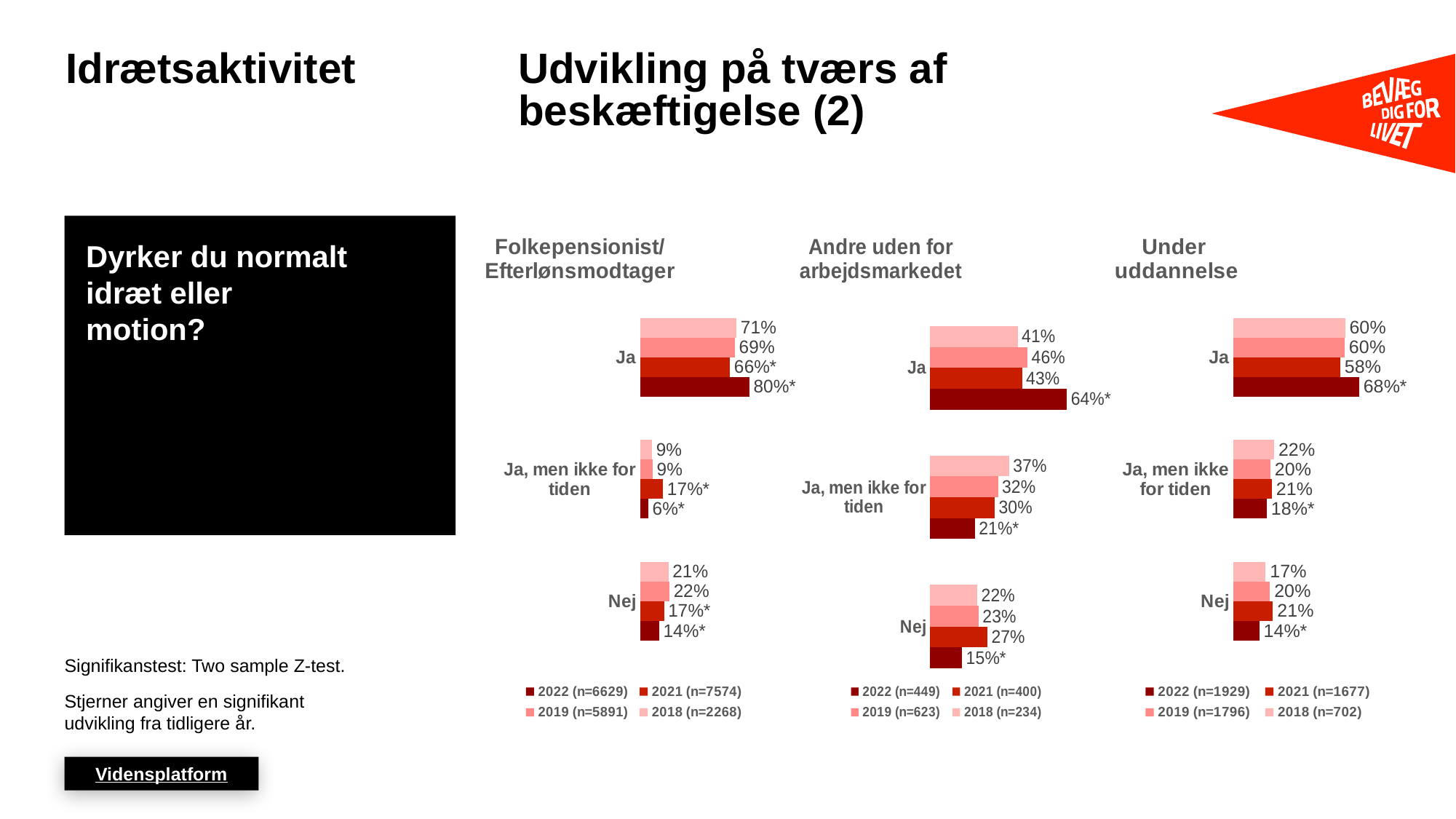
In the 'Under uddannelse' chart, what is the value for 'Nej' in 2021? 21% In the 'Andre uden for arbejdsmarkedet' chart, which year has the highest value for 'Ja'? 2022 In the 'Folkepensionist/Efterlønsmodtager' chart, what is the value for 'Ja' in 2022? 80%* In the 'Andre uden for arbejdsmarkedet' chart, what is the sample size (n) for 2022 shown in the legend? 449 In the 'Folkepensionist/Efterlønsmodtager' chart, which year has the lowest value for 'Ja, men ikke for tiden'? 2022 How many series does the legend list in the 'Folkepensionist/Efterlønsmodtager' chart? 4 How many categories are shown in the 'Under uddannelse' chart? 3 In the 'Under uddannelse' chart, what is the difference between the 2022 and 2021 values for 'Ja'? 10 percentage points In the 'Folkepensionist/Efterlønsmodtager' chart, what is the difference between the 2018 and 2022 values for 'Nej'? 7 percentage points What kind of chart is the 'Andre uden for arbejdsmarkedet' chart? Bar chart In the 'Andre uden for arbejdsmarkedet' chart, what is the value for 'Ja, men ikke for tiden' in 2018? 37% In the 'Andre uden for arbejdsmarkedet' chart, which is larger for 'Nej': the 2021 value or the 2022 value? 2021